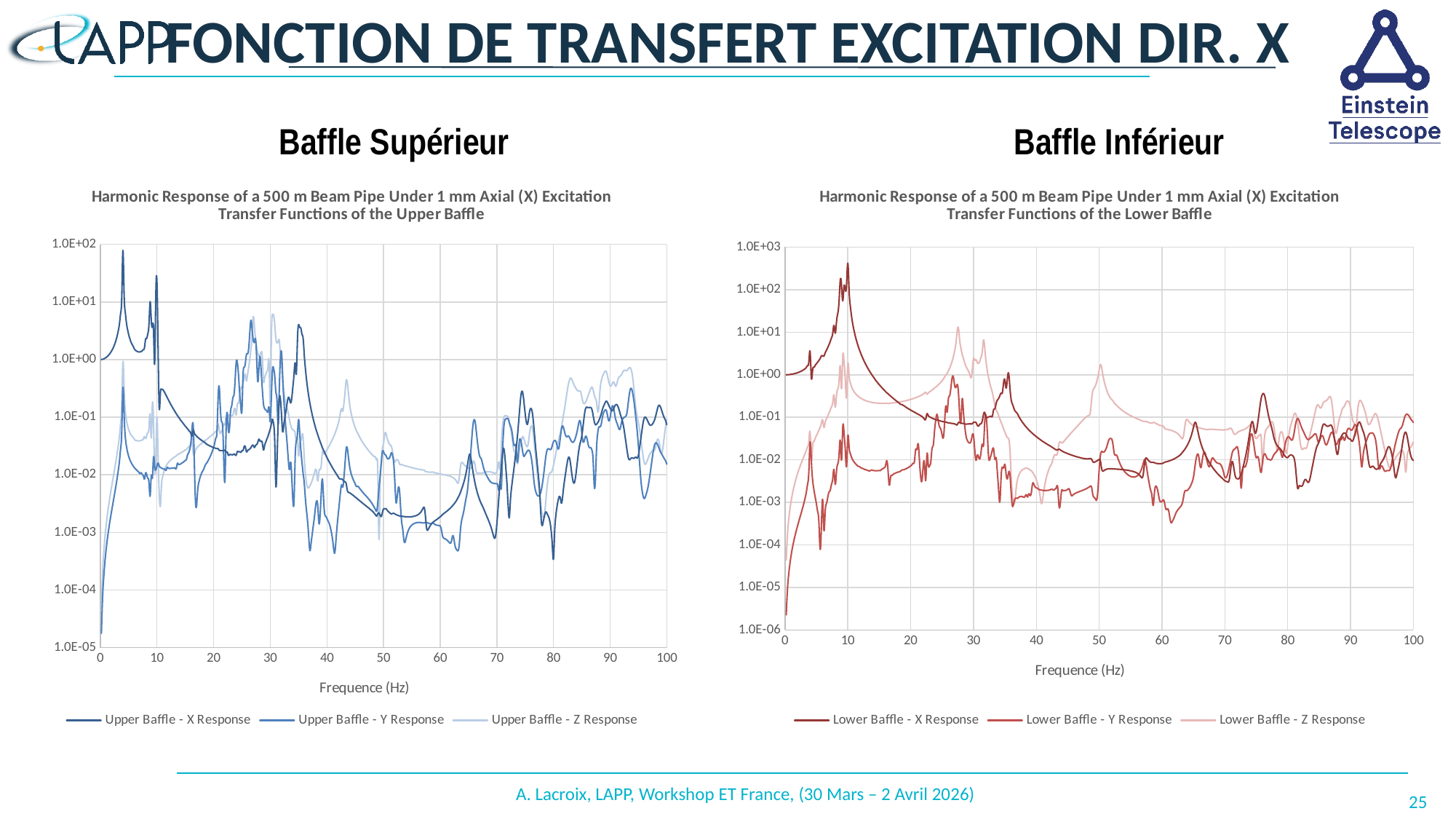
What is the x-axis label of the left chart, 'Transfer Functions of the Upper Baffle'? Frequence (Hz) How many series does the legend of the right chart, 'Transfer Functions of the Lower Baffle', list? 3 In the left chart, 'Transfer Functions of the Upper Baffle', which series reaches the highest peak value? Upper Baffle - X Response In the left chart, 'Transfer Functions of the Upper Baffle', is the peak value of the Upper Baffle - X Response near 4 Hz greater or less than 1.0E+01? greater What kind of chart is the left chart, 'Transfer Functions of the Upper Baffle'? line chart How many series does the legend of the left chart, 'Transfer Functions of the Upper Baffle', list? 3 In the left chart, 'Transfer Functions of the Upper Baffle', is the lowest value of the Upper Baffle - Y Response near 80 Hz greater or less than 1.0E-03? greater In the right chart, 'Transfer Functions of the Lower Baffle', is the lowest value of the Lower Baffle - Y Response near 62 Hz greater or less than 1.0E-03? less In the right chart, 'Transfer Functions of the Lower Baffle', which series reaches the highest peak value? Lower Baffle - X Response In the right chart, 'Transfer Functions of the Lower Baffle', which is larger at its peak near 10 Hz: the Lower Baffle - X Response or the Lower Baffle - Z Response? Lower Baffle - X Response What is the highest value shown on the y axis of the right chart, 'Transfer Functions of the Lower Baffle'? 1.0E+03